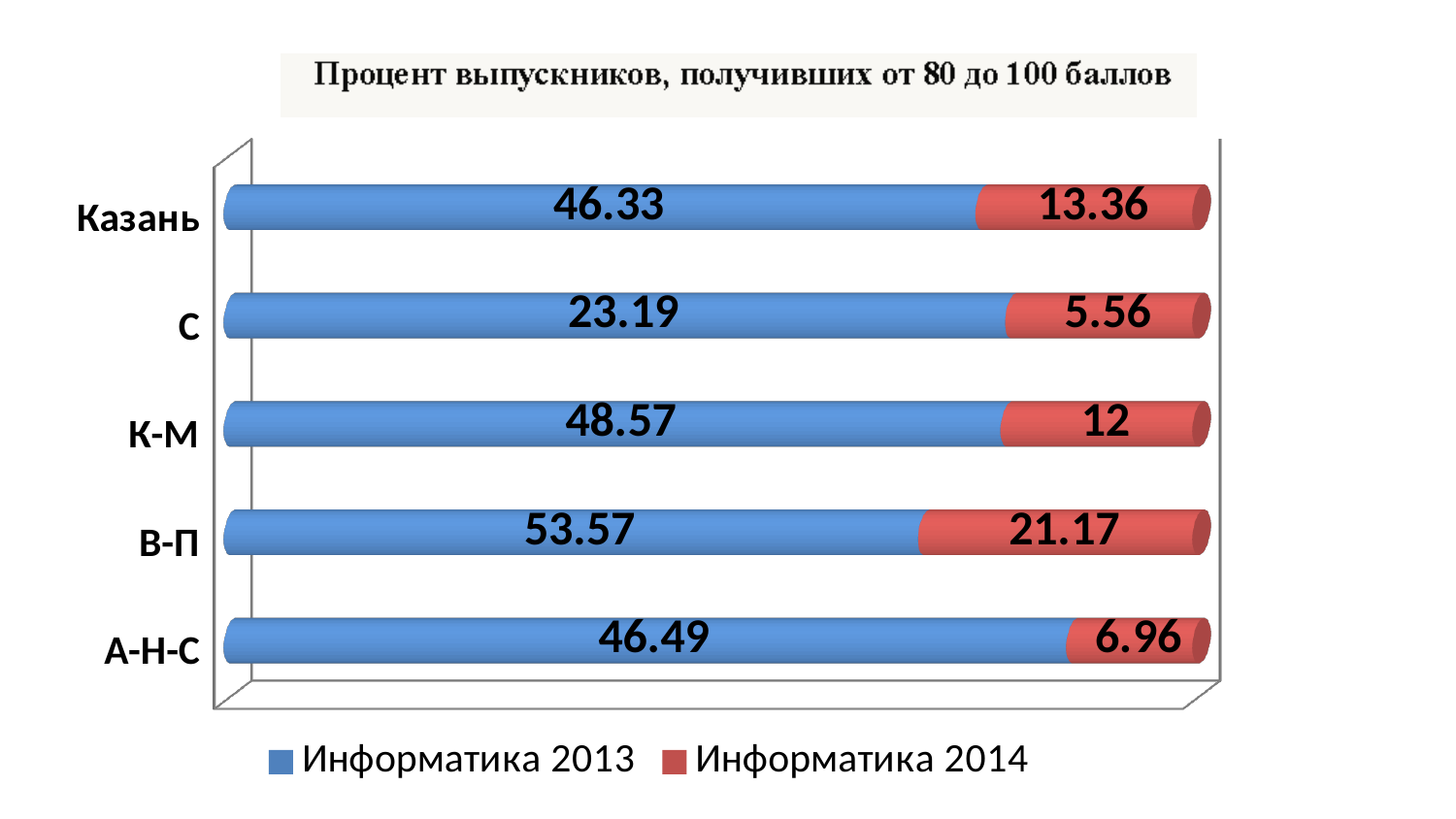
Which is larger: the Информатика 2014 value for Казань or for К-М? Казань How many categories are shown on the chart? 5 Which category has the highest value in the Информатика 2013 series? В-П What kind of chart is shown on the slide? Stacked bar chart What is the difference between the Информатика 2013 and Информатика 2014 values for А-Н-С? 39.53 What is the value for К-М in the Информатика 2014 series? 12 What is the value for Казань in the Информатика 2013 series? 46.33 What is the value for С in the Информатика 2013 series? 23.19 Which category has the lowest value in the Информатика 2014 series? С How many series does the legend list? 2 What is the title of the chart? Процент выпускников, получивших от 80 до 100 баллов What is the value for В-П in the Информатика 2014 series? 21.17